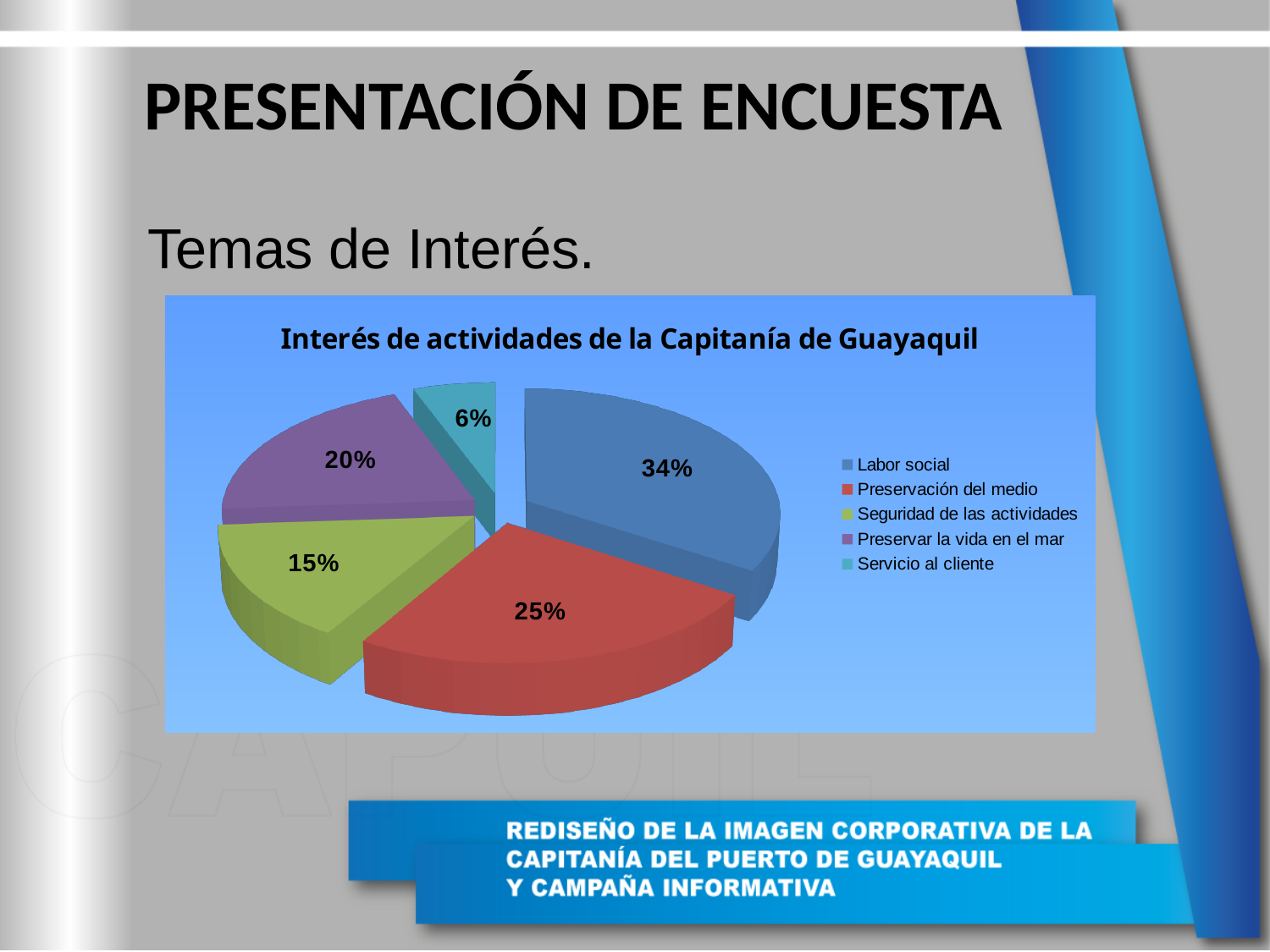
Which category has the largest slice of the pie? Labor social What share of the pie does Preservar la vida en el mar have? 20% What share of the pie does Seguridad de las actividades have? 15% Which category has the smallest slice of the pie? Servicio al cliente What is the difference in percentage points between Labor social and Preservación del medio? 9 How many slices does the pie chart have? 5 What kind of chart is shown on the slide? Pie chart Which is larger, Preservar la vida en el mar or Seguridad de las actividades? Preservar la vida en el mar What share of the pie does Servicio al cliente have? 6% What share of the pie does Labor social have? 34% What is the title of the chart? Interés de actividades de la Capitanía de Guayaquil What share of the pie does Preservación del medio have? 25%